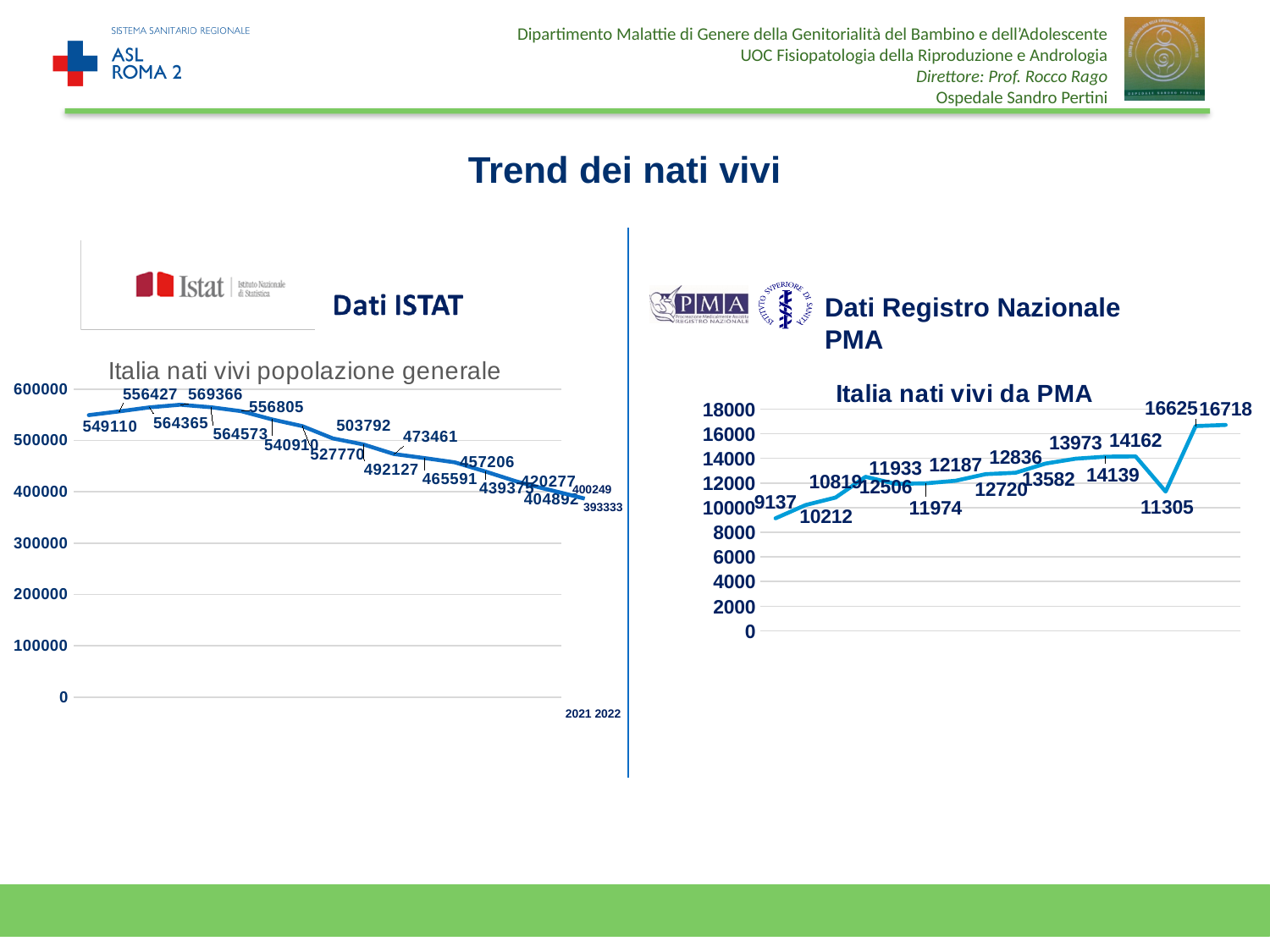
In the 'Italia nati vivi da PMA' chart, what is the lowest value shown? 9137 In the 'Italia nati vivi da PMA' chart, do the values overall rise or fall from left to right? rise In the 'Italia nati vivi popolazione generale' chart, what is the difference between the highest value (569366) and the lowest value (393333)? 176033 In the 'Italia nati vivi da PMA' chart, what is the highest value shown? 16718 In the 'Italia nati vivi da PMA' chart, what is the difference between the last value (16718) and the first value (9137)? 7581 What type of chart is the 'Italia nati vivi popolazione generale' chart on the left? line chart How many data points are plotted in the 'Italia nati vivi popolazione generale' chart? 16 What type of chart is the 'Italia nati vivi da PMA' chart on the right? line chart In the 'Italia nati vivi popolazione generale' chart, do the values overall rise or fall from left to right? fall How many data points are plotted in the 'Italia nati vivi da PMA' chart? 16 In the 'Italia nati vivi popolazione generale' chart, what is the lowest value shown? 393333 In the 'Italia nati vivi popolazione generale' chart, what is the highest value shown? 569366